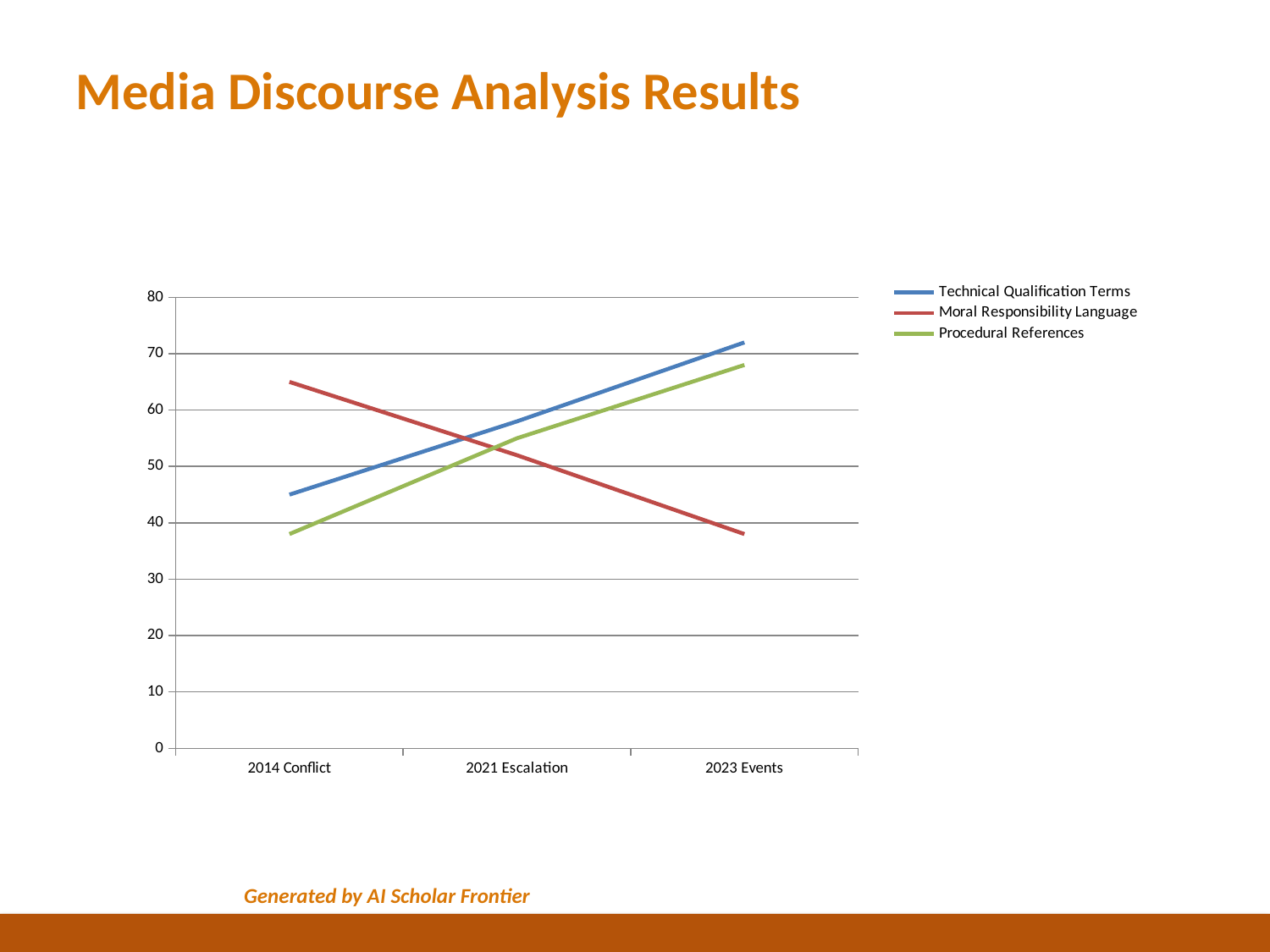
Which series has the highest value at 2023 Events? Technical Qualification Terms Is the value for Procedural References at 2023 Events greater or less than 60? greater Does the Moral Responsibility Language line rise or fall from 2014 Conflict to 2023 Events? fall What kind of chart is shown on the slide? line chart At 2014 Conflict, which is larger: Moral Responsibility Language or Technical Qualification Terms? Moral Responsibility Language Is the value for Technical Qualification Terms at 2014 Conflict greater or less than 50? less Is the value for Moral Responsibility Language at 2023 Events greater or less than 40? less Which series has the lowest value at 2014 Conflict? Procedural References How many categories are shown on the x axis? 3 How many series does the legend list? 3 Does the Technical Qualification Terms line rise or fall from 2014 Conflict to 2023 Events? rise